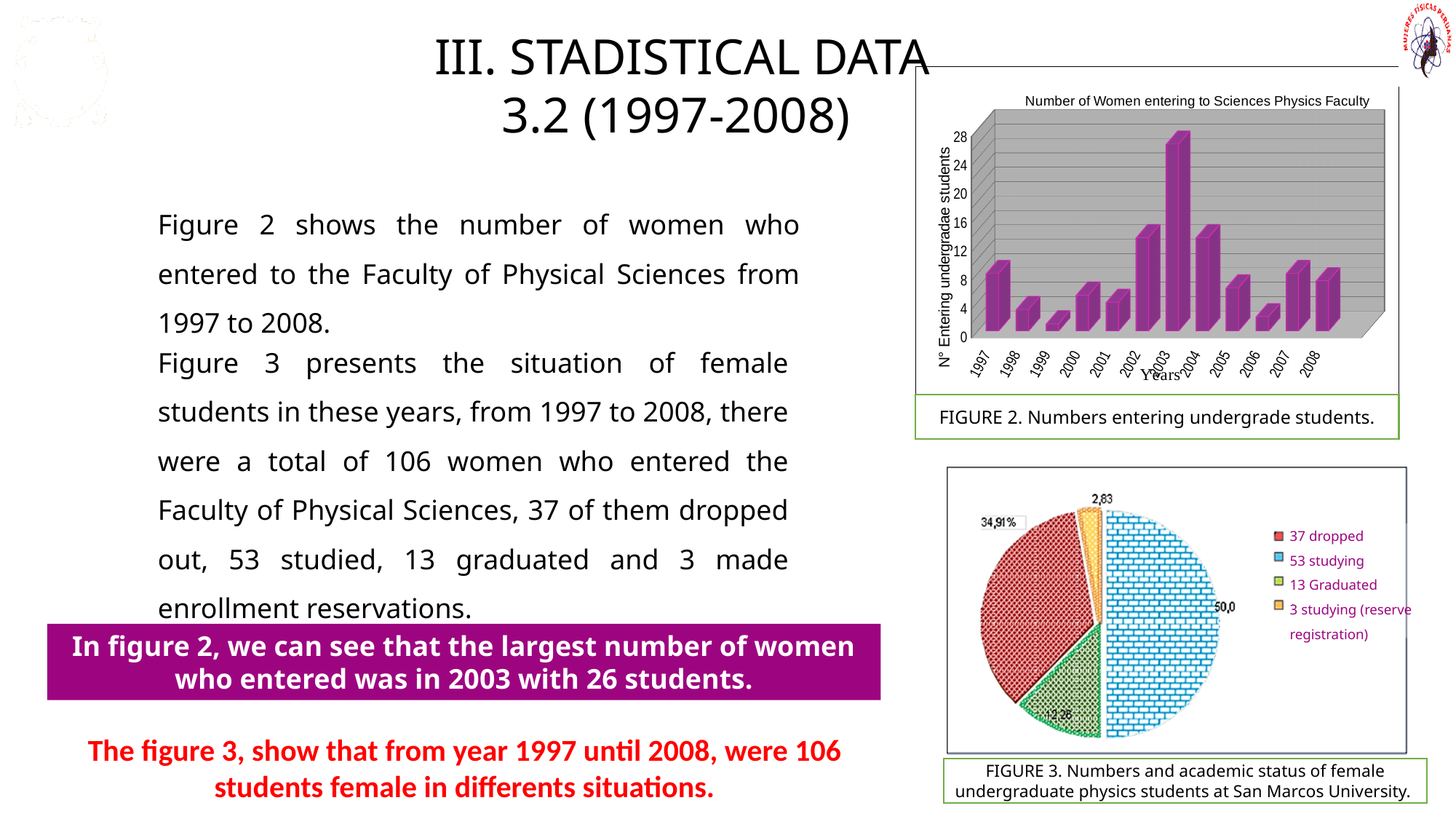
How many entries does the legend of Figure 3 list? 4 In Figure 3, what share of the pie is labelled for the 53 studying students? 50,0 How many years are shown on the x axis of Figure 2? 12 In Figure 2, is the value for 1998 greater or less than 8? less In Figure 2, is the value for 2003 greater or less than 24? greater What is the y-axis title of Figure 2? N° Entering undergradae students What kind of chart is Figure 2 (Number of Women entering to Sciences Physics Faculty)? bar chart In Figure 2, which year has the larger value, 1997 or 1998? 1997 In Figure 2, which year has the larger value, 2006 or 2007? 2007 What kind of chart is Figure 3? pie chart In Figure 2, which year has the highest number of entering undergraduate students? 2003 In Figure 3, what share of the pie is labelled for the dropped students? 34,91%